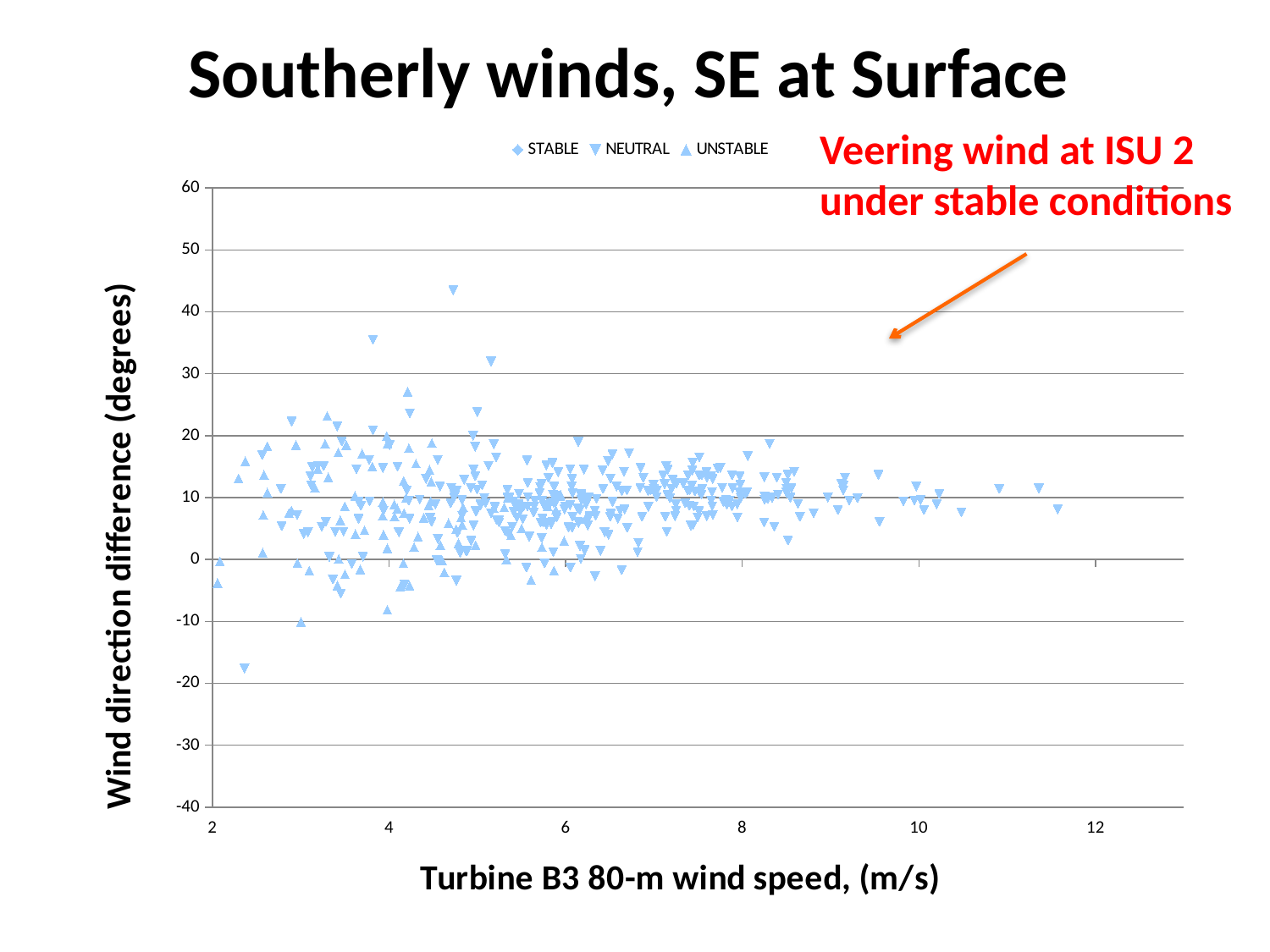
Is the lowest plotted wind direction difference greater or less than -10? less What is the title of the x axis? Turbine B3 80-m wind speed, (m/s) What kind of chart is shown on the slide? scatter chart What are the three series named in the legend? STABLE, NEUTRAL, UNSTABLE How many series does the legend list? 3 Is the highest plotted wind direction difference greater or less than 50? less Is the highest plotted wind direction difference greater or less than 40? greater